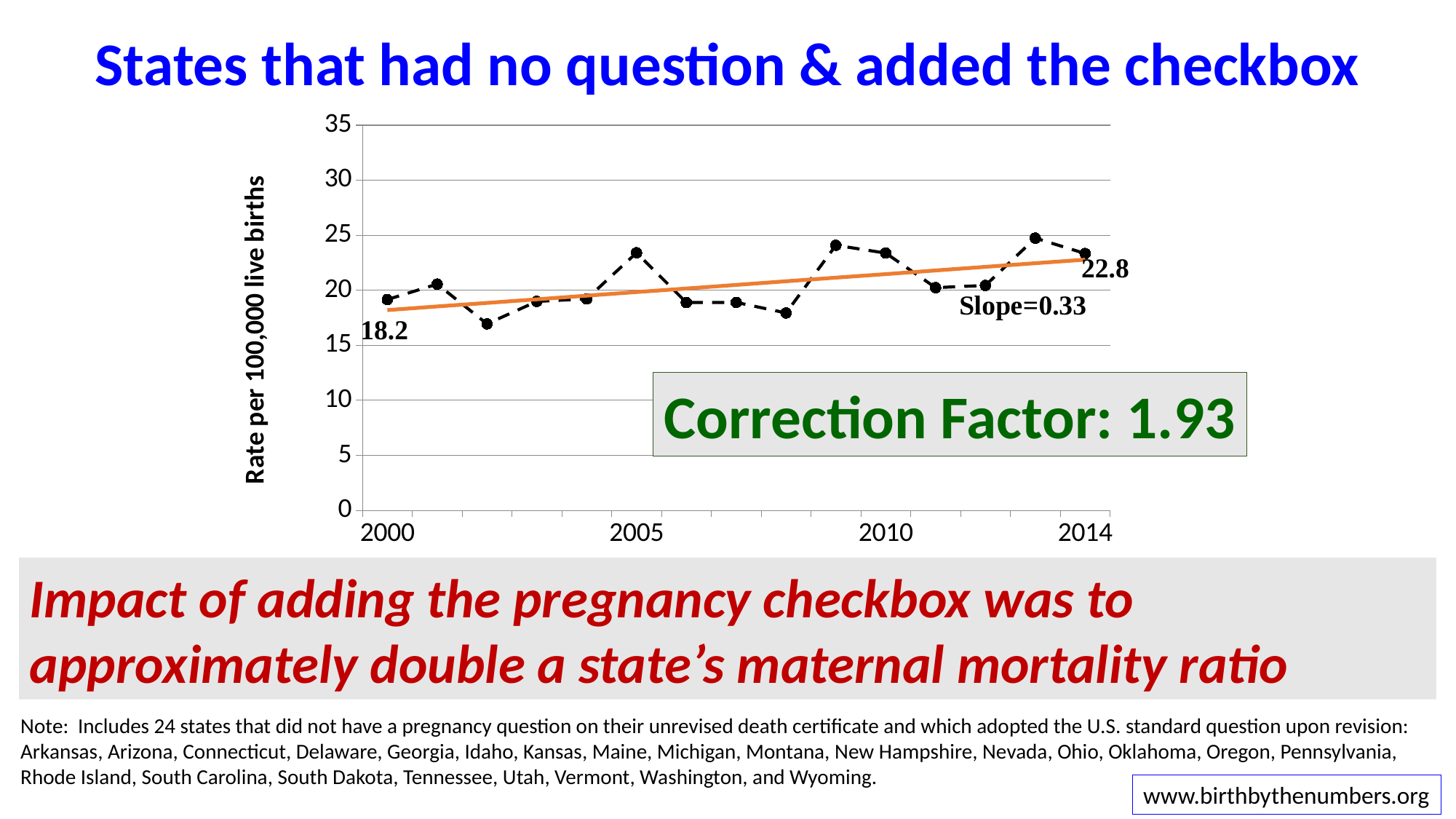
What kind of chart is shown on the slide? line chart What is the value printed at the end of the orange trend line in 2014? 22.8 Is the value for 2005 greater or less than 20? greater What is the value printed at the start of the orange trend line in 2000? 18.2 What is the difference between the trend line's end value (22.8) and its start value (18.2)? 4.6 What slope is printed on the chart for the trend line? Slope=0.33 Does the orange trend line rise or fall from 2000 to 2014? rises Is the value for 2002 greater or less than 20? less How many data points are plotted on the dashed line from 2000 to 2014? 15 Which year has the lowest plotted value on the dashed line? 2002 Is the value for 2008 greater or less than 20? less What is the label on the vertical axis of the chart? Rate per 100,000 live births